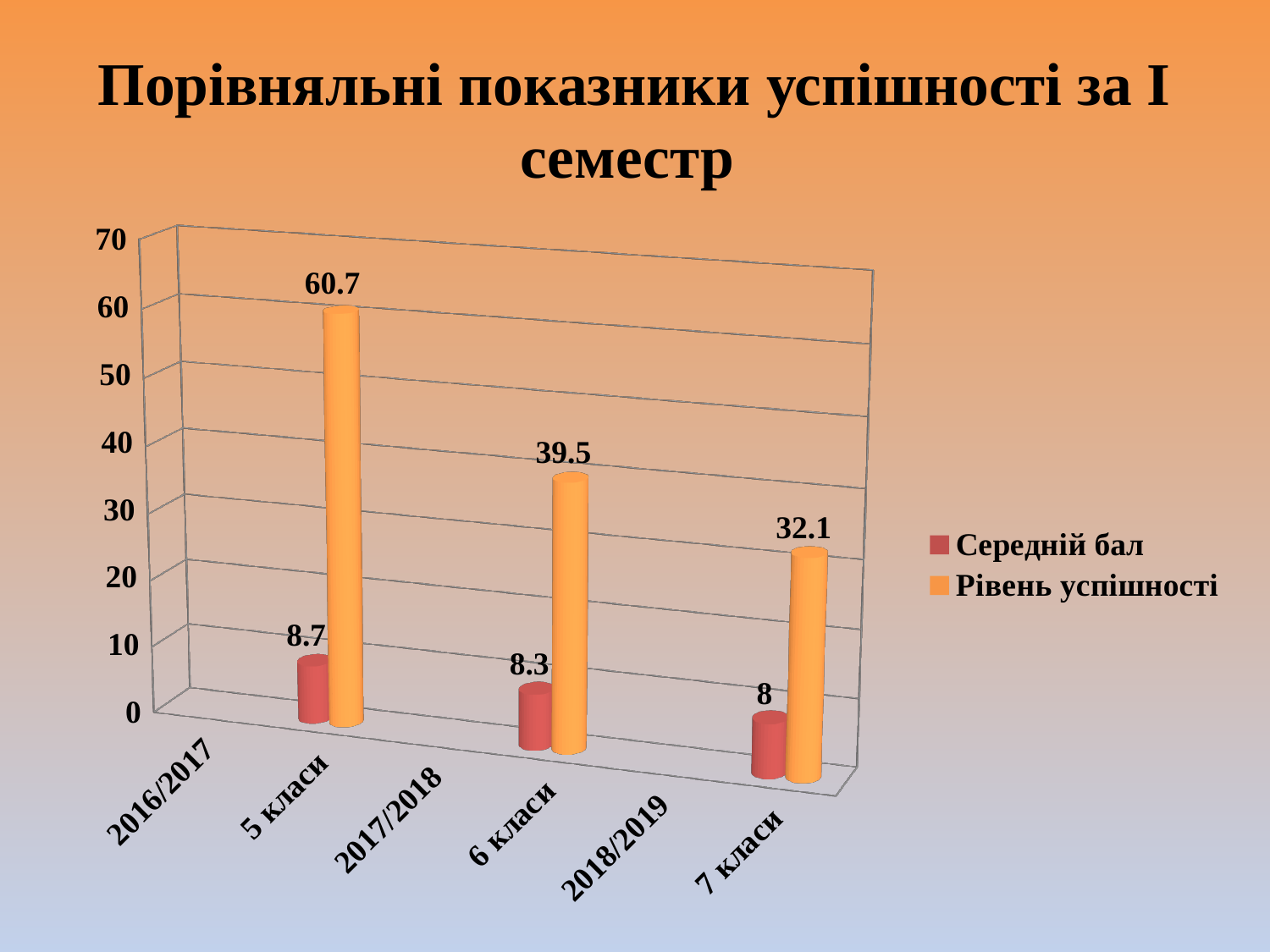
How many series does the legend list? 2 How many categories are shown on the x axis? 6 What is the value of Рівень успішності for 2018/2019 (7 класи)? 32.1 What is the value of Рівень успішності for 2016/2017 (5 класи)? 60.7 What is the difference between Рівень успішності for 2016/2017 (5 класи) and 2017/2018 (6 класи)? 21.2 What kind of chart is shown on the slide? Bar chart What is the value of Середній бал for 2017/2018 (6 класи)? 8.3 What is the value of Середній бал for 2018/2019 (7 класи)? 8 Which is larger: Рівень успішності for 2017/2018 (6 класи) or for 2018/2019 (7 класи)? 2017/2018 (6 класи) Which category has the highest Рівень успішності? 2016/2017 (5 класи) Does Рівень успішності rise or fall across the categories from 2016/2017 to 2018/2019? Fall Which category has the lowest Середній бал? 2018/2019 (7 класи)